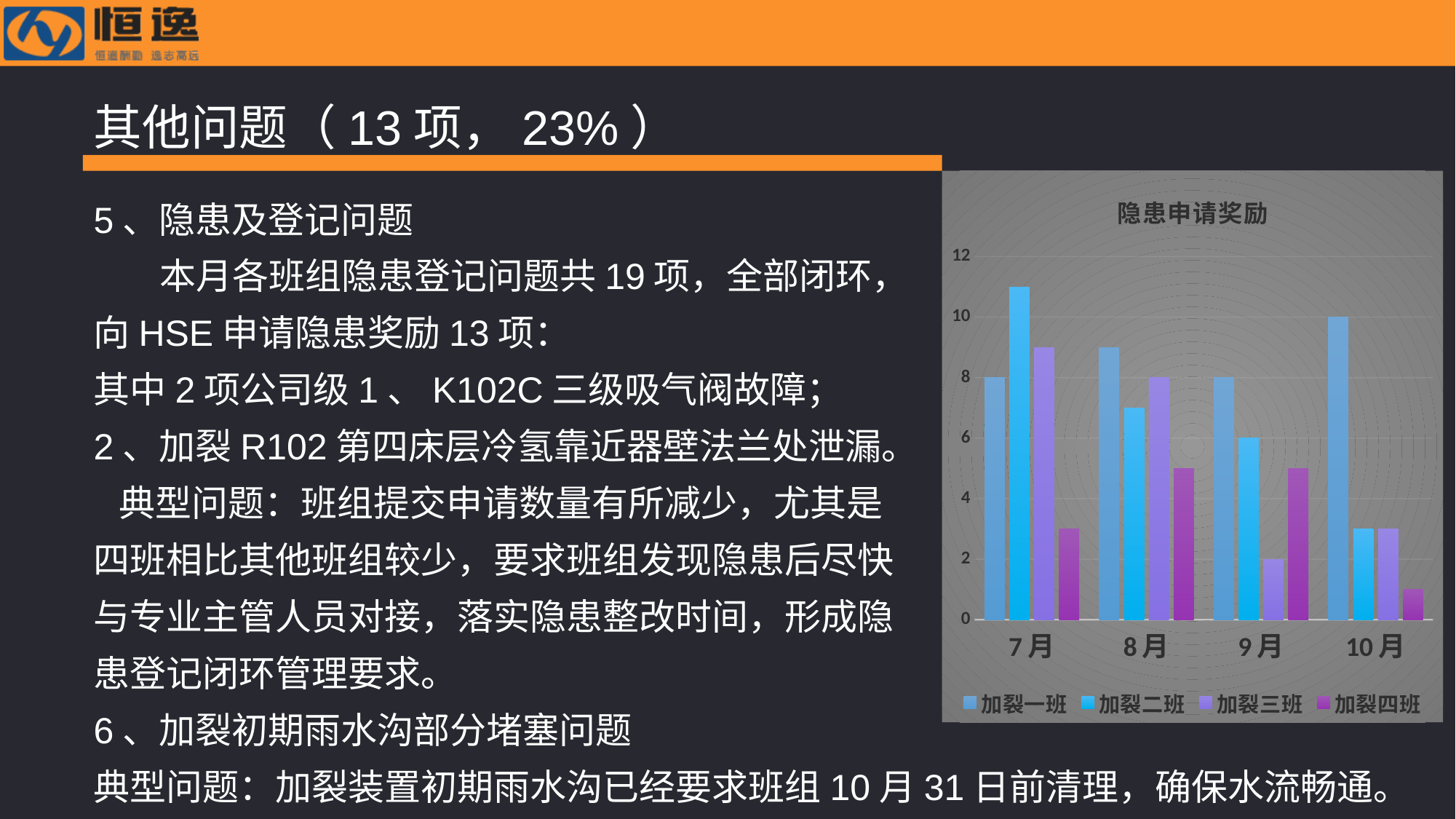
Which series has the highest value in 7月? 加裂二班 In 8月, which is larger: the value for 加裂一班 or the value for 加裂二班? 加裂一班 What is the value for 加裂一班 in 10月? 10 How many months are shown on the x axis of the chart? 4 What kind of chart is shown on the slide? bar chart Which series has the lowest value in 10月? 加裂四班 What is the title of the chart? 隐患申请奖励 How many series does the chart legend list? 4 What is the value for 加裂二班 in 9月? 6 Is the value for 加裂四班 in 8月 greater or less than 6? less Is the value for 加裂二班 in 7月 greater or less than 10? greater What is the value for 加裂三班 in 9月? 2